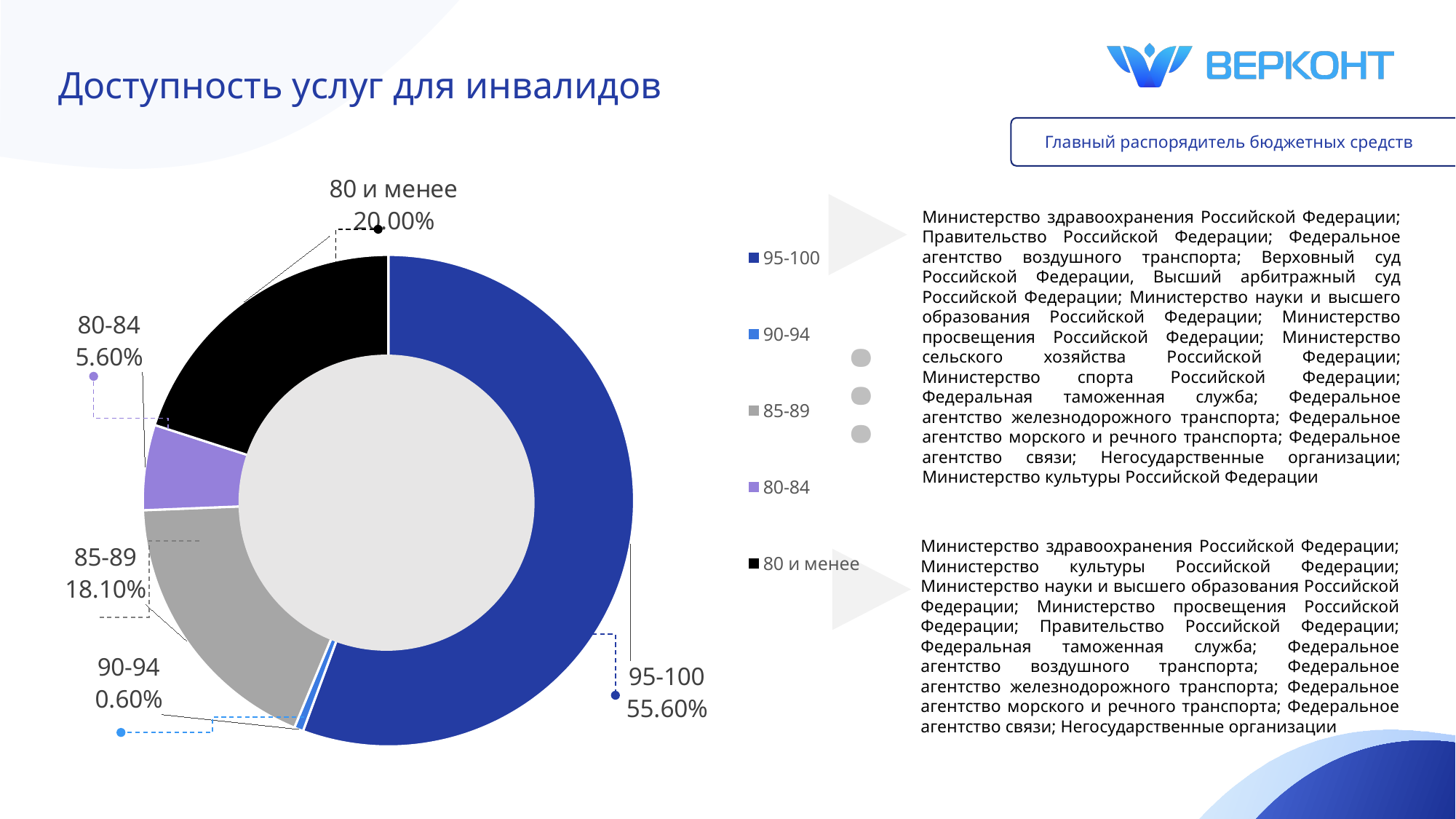
How many categories are shown in the chart? 5 Which category has the largest share of the chart? 95-100 What is the value shown for the 85-89 category? 18.10% What share of the doughnut chart does the 95-100 category hold? 55.60% What is the value shown for the 90-94 category? 0.60% Which category has the smallest share of the chart? 90-94 What is the difference between the shares of '80 и менее' and 85-89? 1.90% Which is larger, the share for 80-84 or the share for 85-89? 85-89 What colour is the segment for the '80 и менее' category? Black How many entries does the legend list? 5 What is the value shown for the '80 и менее' category? 20.00% What type of chart is shown on the slide? Doughnut chart